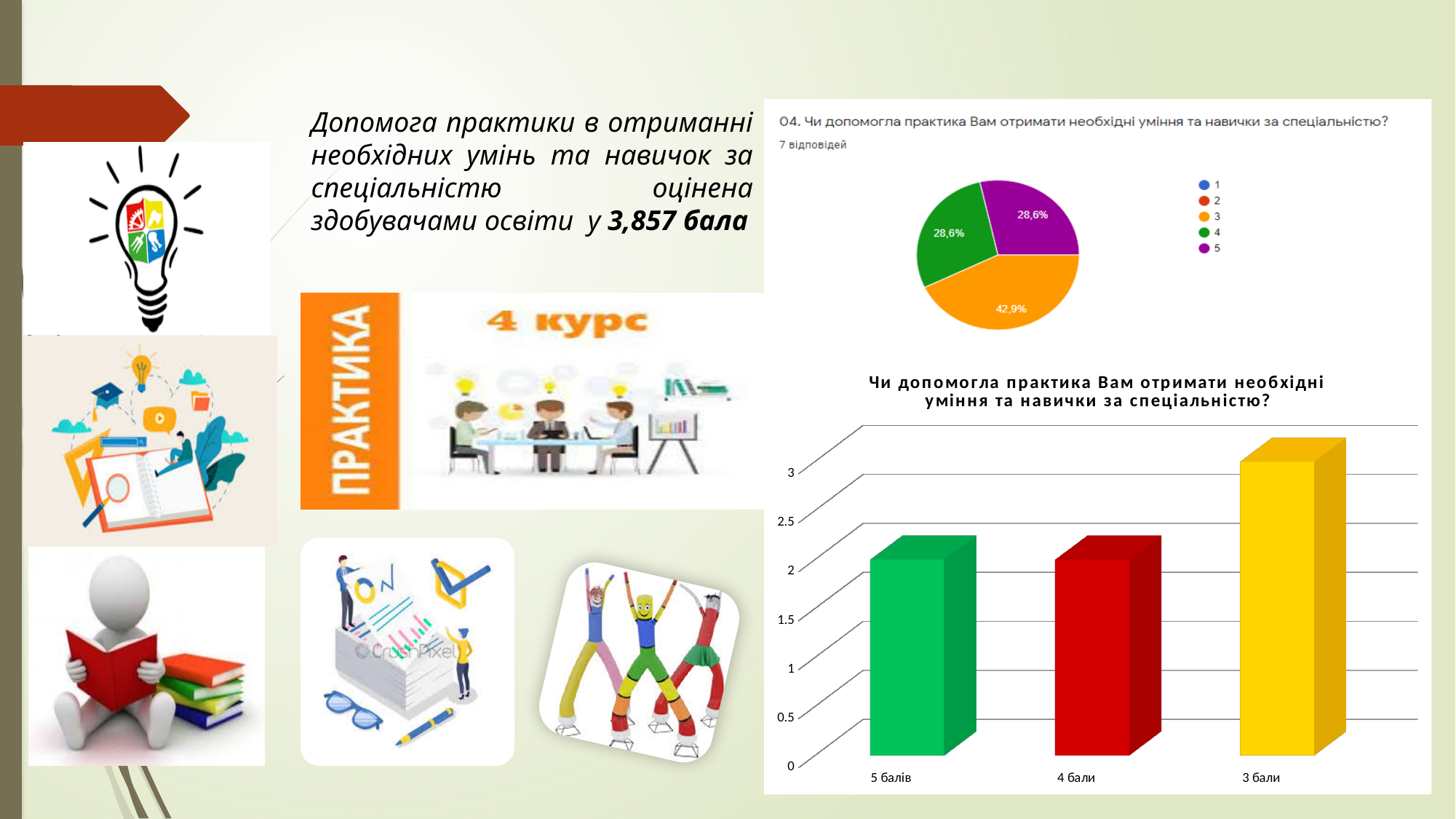
In the pie chart at the top right, which answer option has the largest slice? 3 In the bar chart at the bottom right, what is the value for '5 балів'? 2 In the pie chart at the top right, how many entries does the legend list? 5 In the bar chart at the bottom right, which category has the highest bar? 3 бали In the pie chart at the top right, what share of responses is shown for the orange slice (answer 3)? 42,9% In the bar chart at the bottom right, how many categories are shown on the x axis? 3 In the pie chart at the top right, what share of responses is shown for the purple slice (answer 5)? 28,6% In the pie chart at the top right, how many responses does the caption say were collected? 7 відповідей What kind of chart is the one at the bottom right titled 'Чи допомогла практика Вам отримати необхідні уміння та навички за спеціальністю?'? bar chart In the pie chart at the top right, what is the difference between the share for answer 3 and the share for answer 4? 14,3% In the bar chart at the bottom right, what is the value for '3 бали'? 3 In the bar chart at the bottom right, is the value for '4 бали' greater or less than 2.5? less